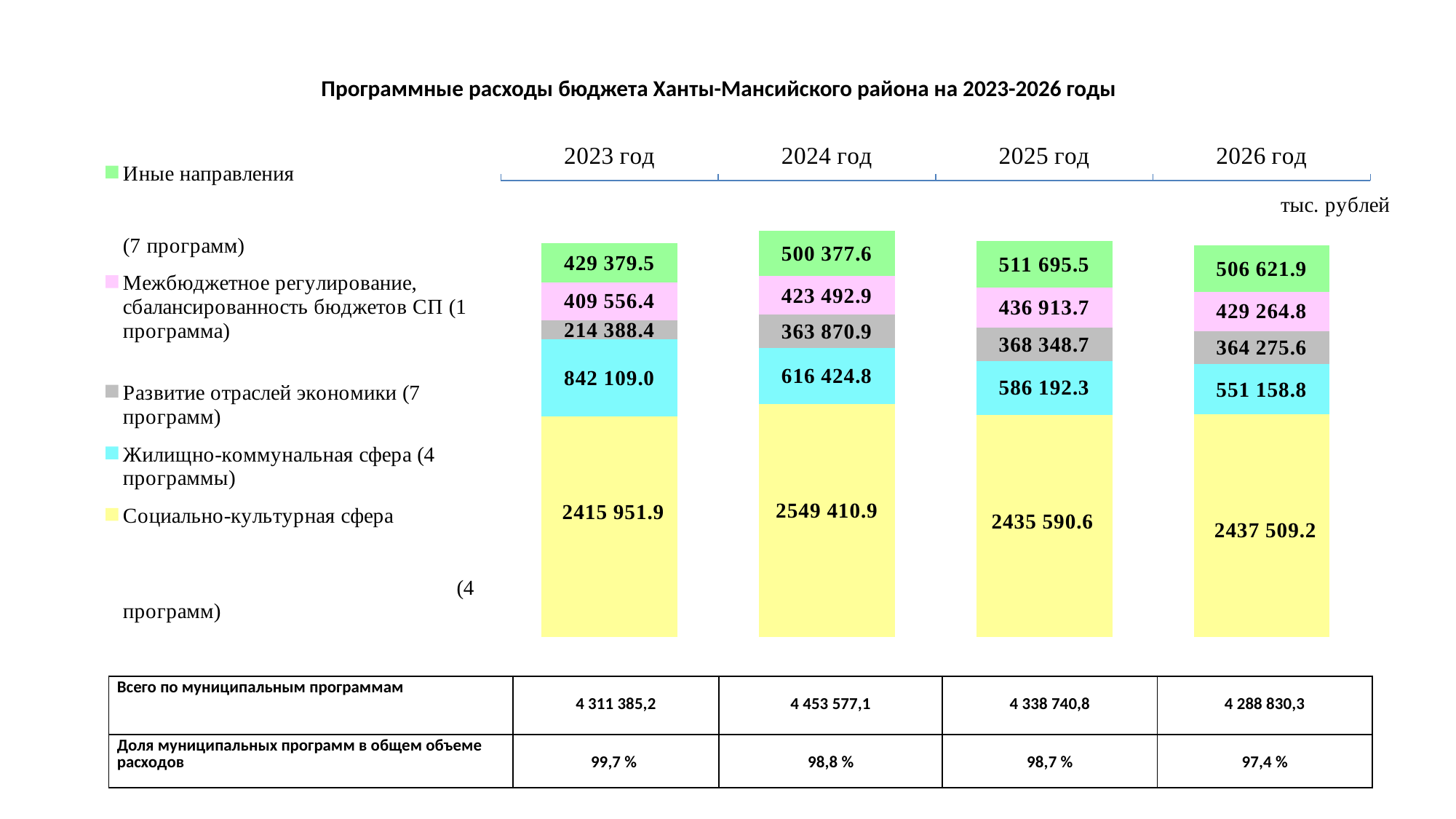
In which year is the value for Социально-культурная сфера the highest? 2024 год What is the value for Социально-культурная сфера in 2024 год? 2549 410.9 Which is larger: Иные направления in 2025 год or Иные направления in 2026 год? 2025 год Does the value for Жилищно-коммунальная сфера rise or fall from 2023 год to 2026 год? fall What is the value for Жилищно-коммунальная сфера in 2023 год? 842 109.0 How many years (categories) are shown on the x axis? 4 What kind of chart is shown on the slide? stacked bar chart What is the value for Развитие отраслей экономики in 2026 год? 364 275.6 What is the total of the stacked bar for 2023 год? 4 311 385,2 In which year is the value for Развитие отраслей экономики the lowest? 2023 год How many series does the legend list? 5 What is the difference between the Жилищно-коммунальная сфера values for 2023 год and 2026 год? 290 950.2